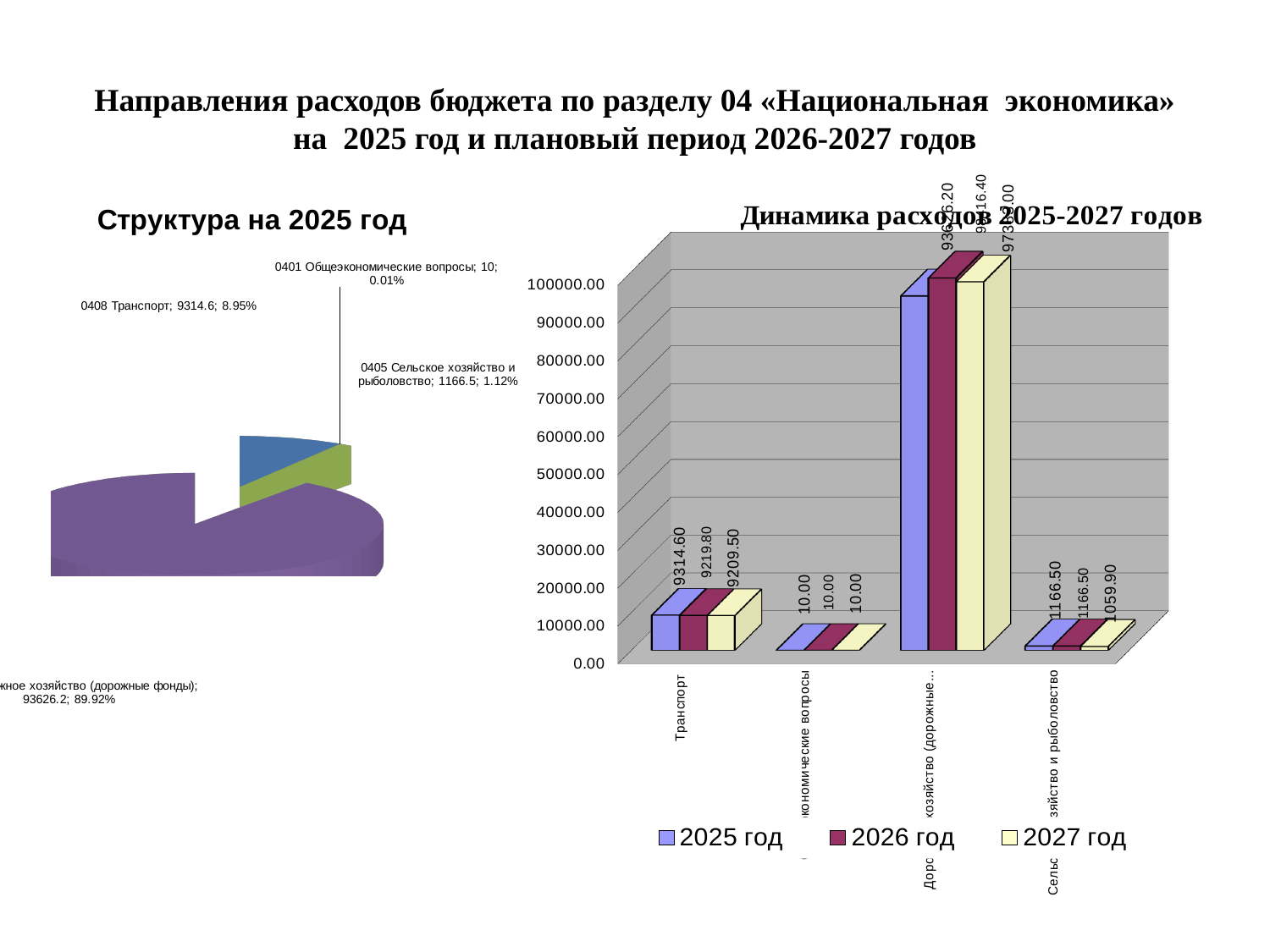
In the pie chart "Структура на 2025 год", what share does the largest slice have? 89.92% How many series does the legend of the chart "Динамика расходов 2025-2027 годов" list? 3 In the pie chart "Структура на 2025 год", what share does 0408 Транспорт have? 8.95% In the chart "Динамика расходов 2025-2027 годов", what is the value for Транспорт in 2027 год? 9209.50 In the chart "Динамика расходов 2025-2027 годов", what is the value for Сельское хозяйство и рыболовство in 2027 год? 1059.90 In the chart "Динамика расходов 2025-2027 годов", what is the difference between the Транспорт values for 2025 год and 2026 год? 94.80 What kind of chart is "Динамика расходов 2025-2027 годов"? bar chart In the chart "Динамика расходов 2025-2027 годов", do the values for Транспорт rise or fall from 2025 год to 2027 год? fall How many slices does the pie chart "Структура на 2025 год" have? 4 In the pie chart "Структура на 2025 год", what value is shown for 0405 Сельское хозяйство и рыболовство? 1166.5 In the chart "Динамика расходов 2025-2027 годов", what is the value for Транспорт in 2025 год? 9314.60 In the pie chart "Структура на 2025 год", what share does 0401 Общеэкономические вопросы have? 0.01%